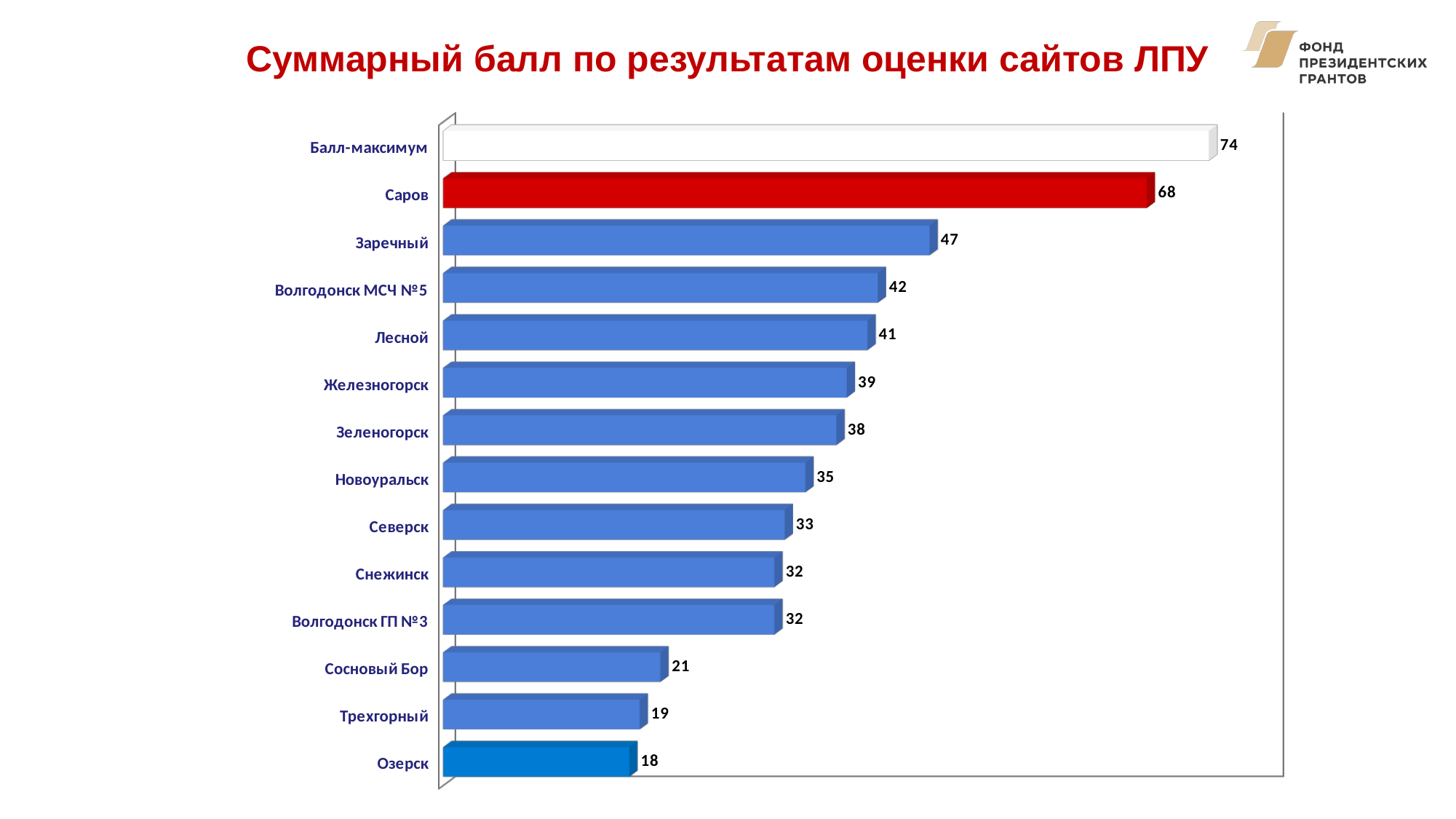
Which category has the lowest value? Озерск What is the value shown for Балл-максимум? 74 What is the value for Саров? 68 Excluding Балл-максимум, which city has the highest score? Саров Which is larger, the value for Лесной or the value for Новоуральск? Лесной What is the difference between Балл-максимум and the value for Саров? 6 What is the difference between the values for Саров and Заречный? 21 What is the value for Озерск? 18 How many categories are shown in the chart? 14 What is the value for Волгодонск МСЧ №5? 42 What kind of chart is shown on the slide? Bar chart What colour is the bar for Саров? Red